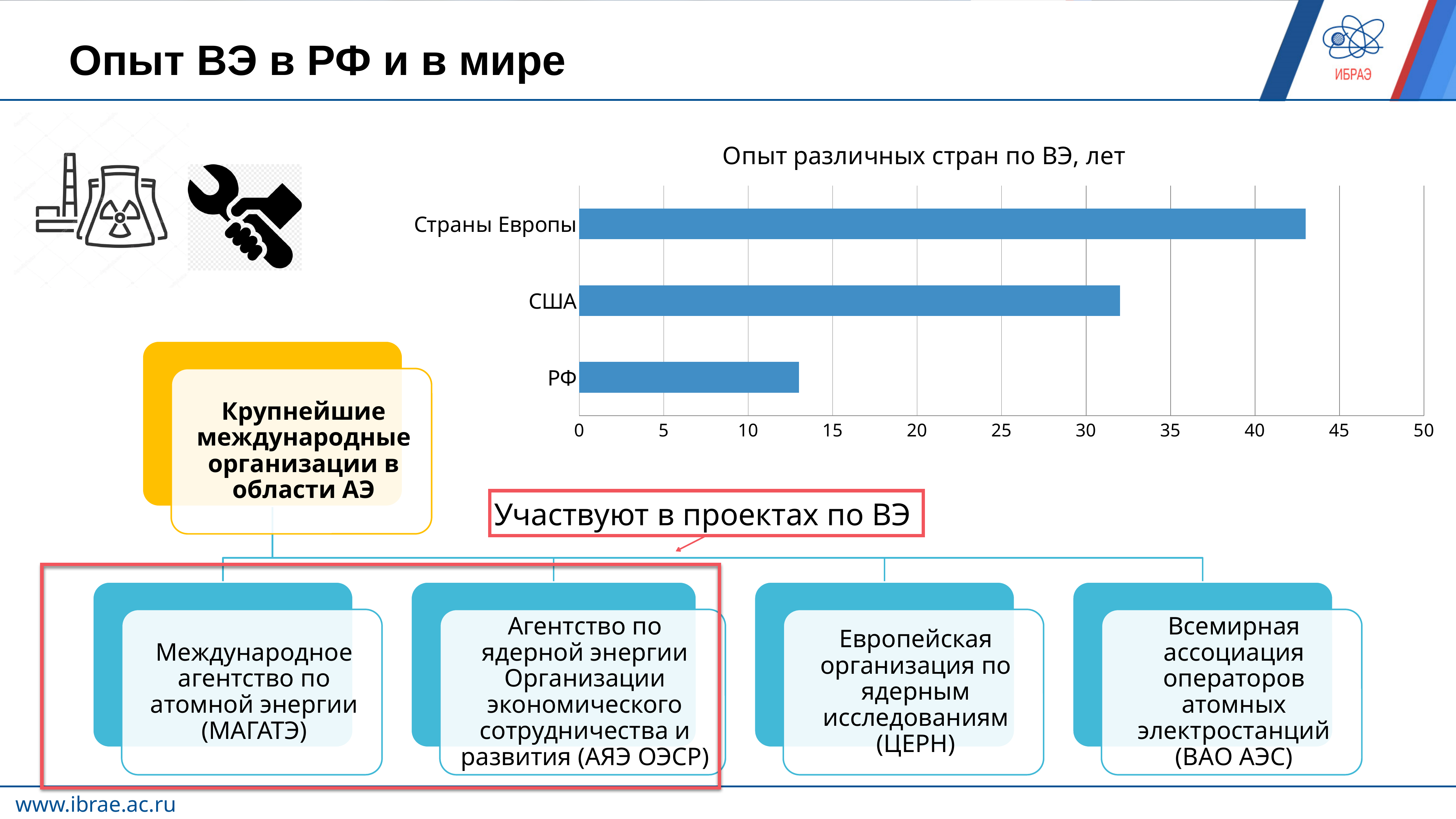
What kind of chart is shown under the title "Опыт различных стран по ВЭ, лет"? bar chart Which category has the lowest value in the chart "Опыт различных стран по ВЭ, лет"? РФ How many categories are plotted in the chart "Опыт различных стран по ВЭ, лет"? 3 What is the maximum value shown on the horizontal axis of the chart "Опыт различных стран по ВЭ, лет"? 50 Is the value for Страны Европы in the chart "Опыт различных стран по ВЭ, лет" greater or less than 40? greater In the chart "Опыт различных стран по ВЭ, лет", which is larger: the value for Страны Европы or the value for США? Страны Европы Is the value for США in the chart "Опыт различных стран по ВЭ, лет" greater or less than 35? less What is the title of the chart on the slide? Опыт различных стран по ВЭ, лет Which category has the highest value in the chart "Опыт различных стран по ВЭ, лет"? Страны Европы In the chart "Опыт различных стран по ВЭ, лет", which is larger: the value for США or the value for РФ? США Is the value for РФ in the chart "Опыт различных стран по ВЭ, лет" greater or less than 15? less